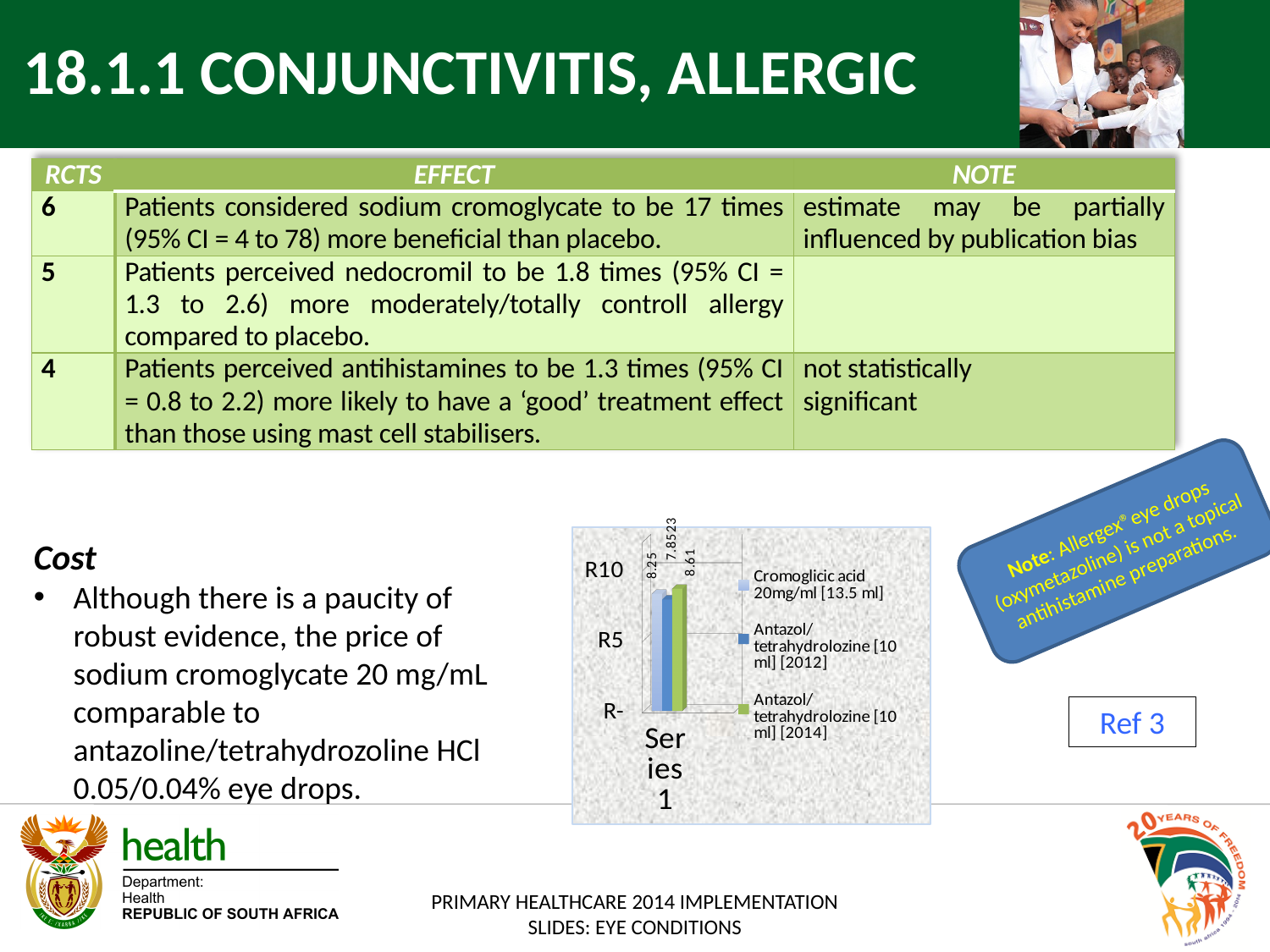
Which is larger, the labelled value for Cromoglicic acid 20mg/ml [13.5 ml] or for Antazol/tetrahydrolozine [10 ml] [2012]? Cromoglicic acid 20mg/ml [13.5 ml] What value is labelled for Antazol/tetrahydrolozine [10 ml] [2012]? 7.8523 How many series does the chart legend list? 3 What value is labelled for Antazol/tetrahydrolozine [10 ml] [2014]? 8.61 Is the value for Cromoglicic acid 20mg/ml [13.5 ml] greater or less than R5? greater What kind of chart is shown on the slide? bar chart Which series has the highest labelled value? Antazol/tetrahydrolozine [10 ml] [2014] What is the label of the single category on the chart's x axis? Series 1 Is the value for Antazol/tetrahydrolozine [10 ml] [2014] greater or less than R10? less Which series has the lowest labelled value? Antazol/tetrahydrolozine [10 ml] [2012] What value is labelled for Cromoglicic acid 20mg/ml [13.5 ml]? 8.25 What is the difference between the labelled values for Antazol/tetrahydrolozine [10 ml] [2014] and Antazol/tetrahydrolozine [10 ml] [2012]? 0.7577